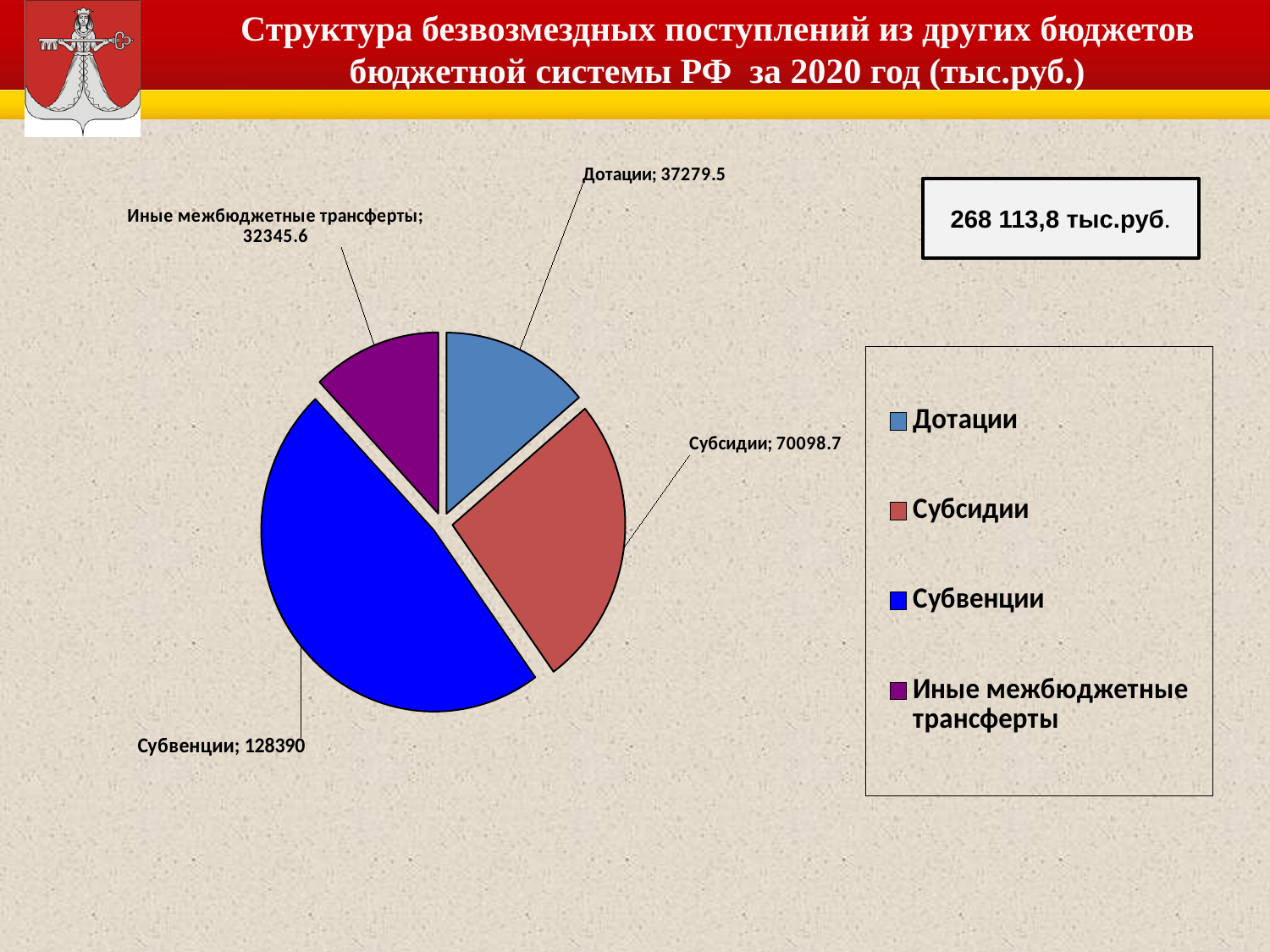
What is the value for Субсидии? 70098.7 What is the difference between the values for Дотации and Иные межбюджетные трансферты? 4933.9 Which category has the largest slice of the pie? Субвенции What type of chart is shown on the slide? pie chart Which category has the smallest slice of the pie? Иные межбюджетные трансферты What is the value for Иные межбюджетные трансферты? 32345.6 Which is larger, Субсидии or Дотации? Субсидии What is the value for Дотации? 37279.5 What is the value for Субвенции? 128390 What colour is the Субвенции slice? blue How many categories does the pie chart have? 4 What is the difference between the values for Субвенции and Субсидии? 58291.3